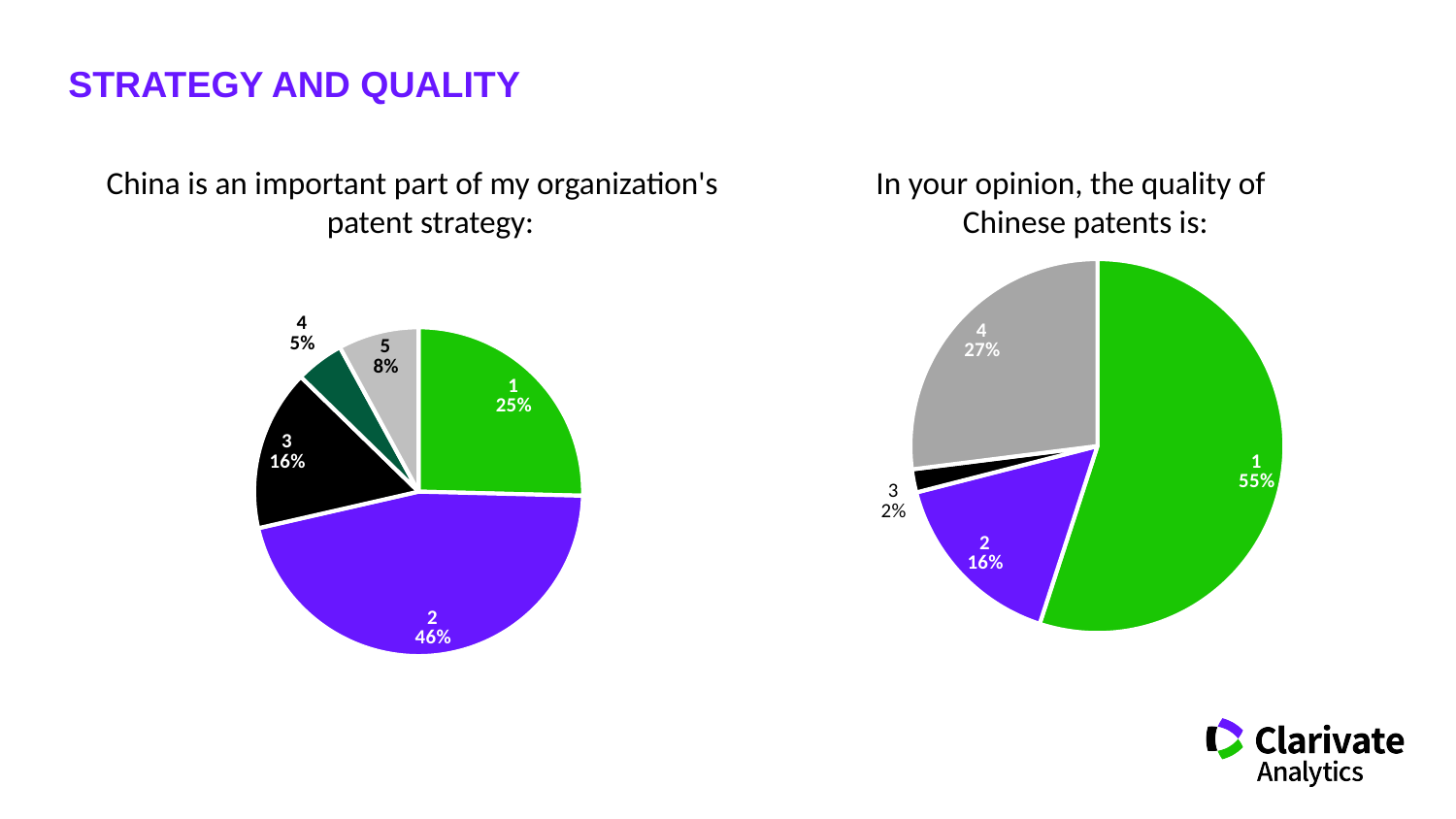
In the 'China is an important part of my organization's patent strategy' chart, what is the difference between the shares of category 1 and category 3? 9% In the 'China is an important part of my organization's patent strategy' chart, what share does category 2 have? 46% In the 'In your opinion, the quality of Chinese patents is' chart, how many slices does the pie have? 4 What kind of chart is used on the right side of the slide? Pie chart In the 'In your opinion, the quality of Chinese patents is' chart, which is larger, category 2 or category 4? 4 In the 'In your opinion, the quality of Chinese patents is' chart, what share does category 1 have? 55% In the 'China is an important part of my organization's patent strategy' chart, what share does category 5 have? 8% In the 'In your opinion, the quality of Chinese patents is' chart, which category has the largest slice? 1 In the 'China is an important part of my organization's patent strategy' chart, which category has the largest slice? 2 In the 'China is an important part of my organization's patent strategy' chart, which category has the smallest slice? 4 In the 'China is an important part of my organization's patent strategy' chart, how many slices does the pie have? 5 In the 'In your opinion, the quality of Chinese patents is' chart, what share does category 3 have? 2%